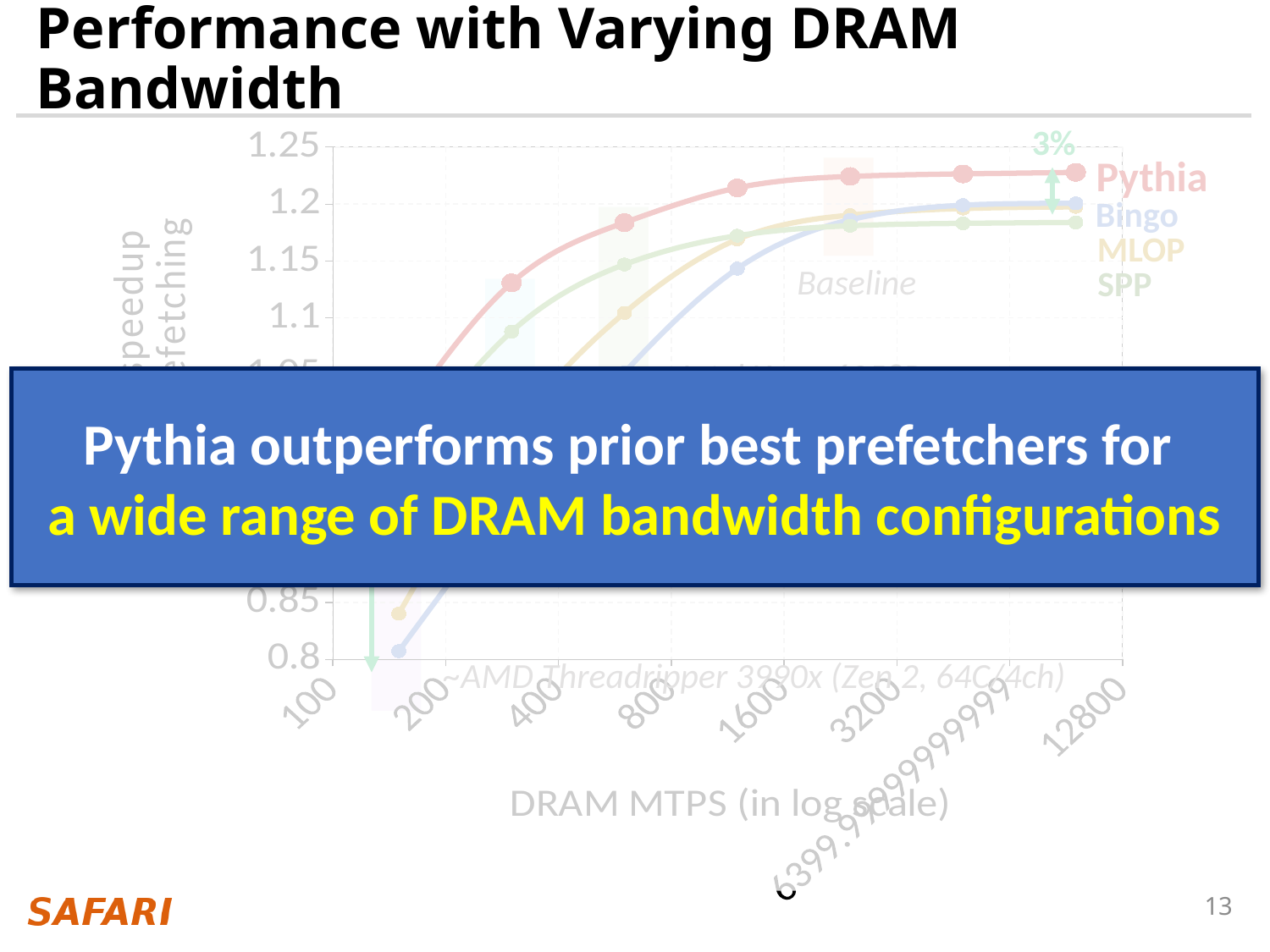
What percentage is annotated at the right end of the chart between Pythia and the next best prefetcher? 3% Is the value for Bingo at 100 DRAM MTPS greater or less than 0.85? less Which series has the highest speedup at 12800 DRAM MTPS? Pythia Is the value for Pythia at 400 DRAM MTPS greater or less than 1.1? greater Is the value for Pythia at 12800 DRAM MTPS greater or less than 1.2? greater How many series does the chart's legend list? 4 Which is larger at 12800 DRAM MTPS, the value for Pythia or the value for SPP? Pythia Do the speedup values rise or fall as DRAM MTPS increases along the x axis? rise What kind of chart is shown on the slide? line chart What is the label of the x axis? DRAM MTPS (in log scale)